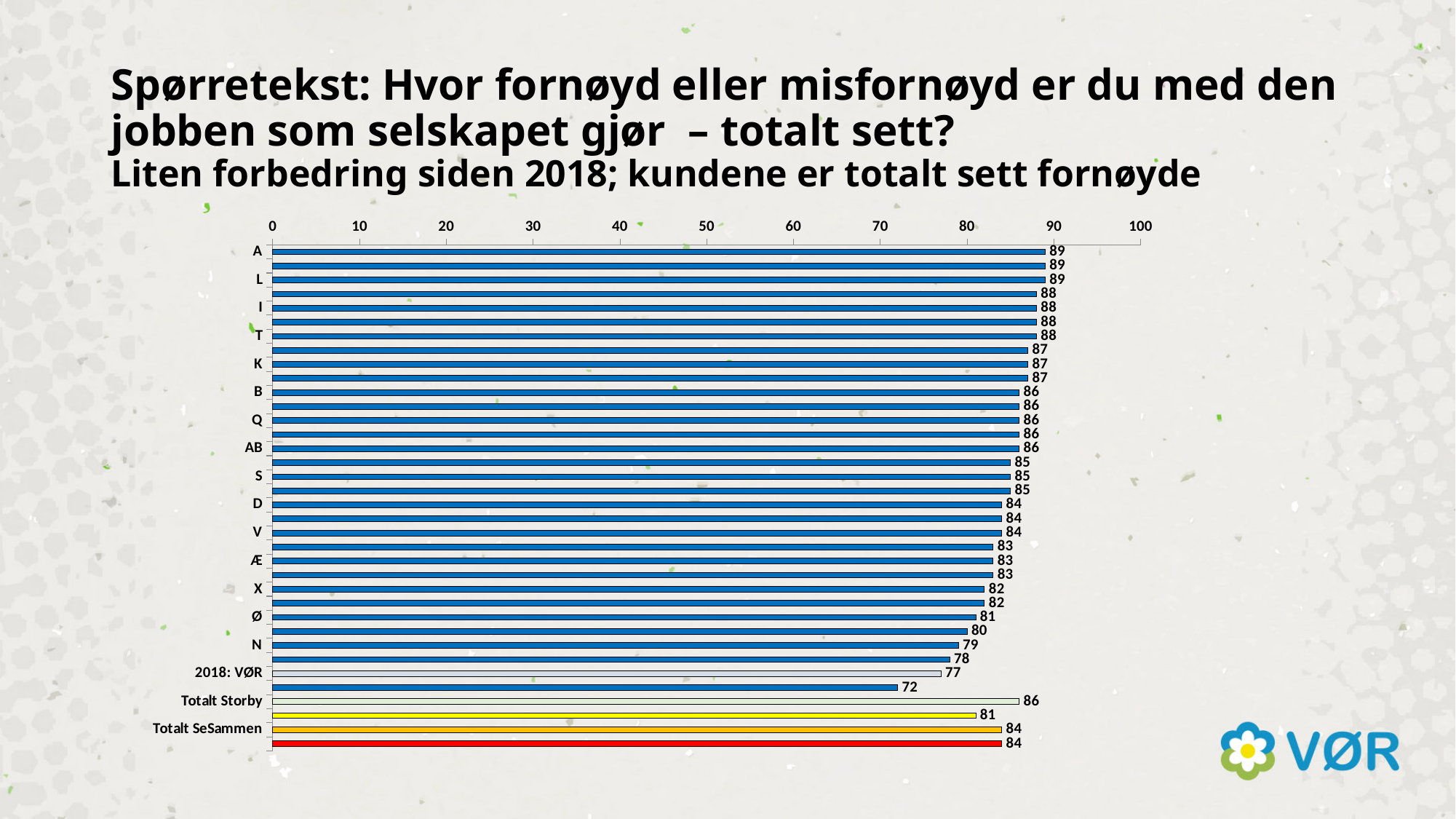
What is the highest value shown on the chart? 89 Is the value for N greater or less than 80? less What is the value for 2018: VØR? 77 What is the value for A? 89 What is the value for Totalt Storby? 86 Which has the larger value, K or Ø? K What is the value for Æ? 83 What is the value for Totalt SeSammen? 84 What is the value for N? 79 What is the difference between the values for Totalt Storby and 2018: VØR? 9 What kind of chart is shown on the slide? Bar chart What is the lowest value shown on the chart? 72